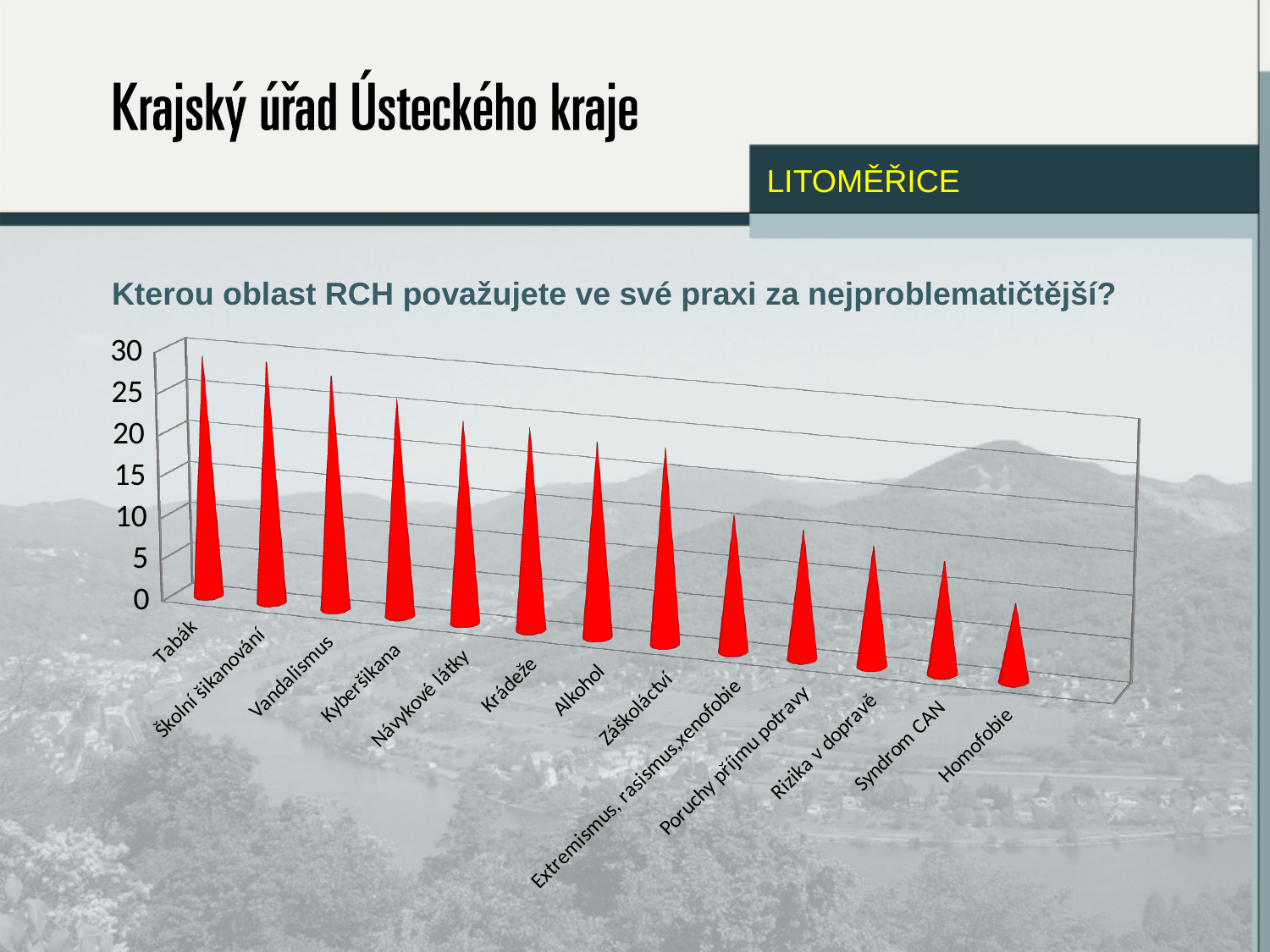
Is the value for Homofobie greater or less than 15? less What kind of chart is shown on the slide? Bar chart Which is larger, the value for Tabák or the value for Homofobie? Tabák How many categories are plotted on the chart? 13 Is the value for Syndrom CAN greater or less than 15? less Which category has the lowest value on the chart? Homofobie Do the values rise or fall moving from left to right along the x axis? Fall Is the value for Tabák greater or less than 25? greater What question is shown as the title above the chart? Kterou oblast RCH považujete ve své praxi za nejproblematičtější? What colour are the bars on the chart? Red Which is larger, the value for Vandalismus or the value for Syndrom CAN? Vandalismus